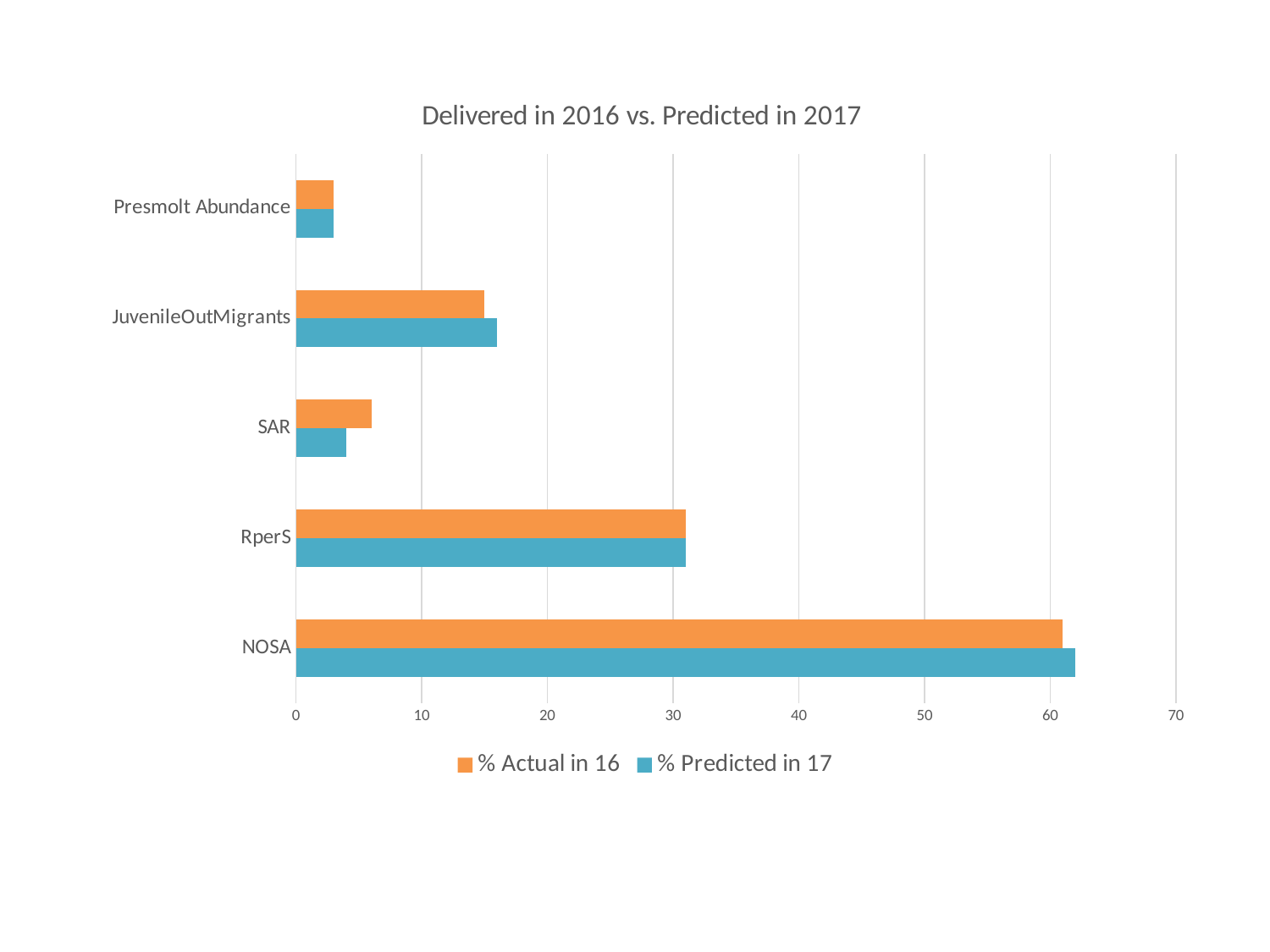
Which category has the lowest value for % Actual in 16? Presmolt Abundance How many categories are shown on the chart? 5 What is the title of the chart? Delivered in 2016 vs. Predicted in 2017 Is the % Actual in 16 value for NOSA greater or less than 50? greater For SAR, which is larger: % Actual in 16 or % Predicted in 17? % Actual in 16 Which category has the highest value for % Actual in 16? NOSA How many series does the legend list? 2 Is the % Actual in 16 value for SAR greater or less than 10? less Is the % Predicted in 17 value for RperS greater or less than 20? greater What kind of chart is shown on the slide? bar chart Which category has the highest value for % Predicted in 17? NOSA Which colour represents % Predicted in 17 in the legend? blue